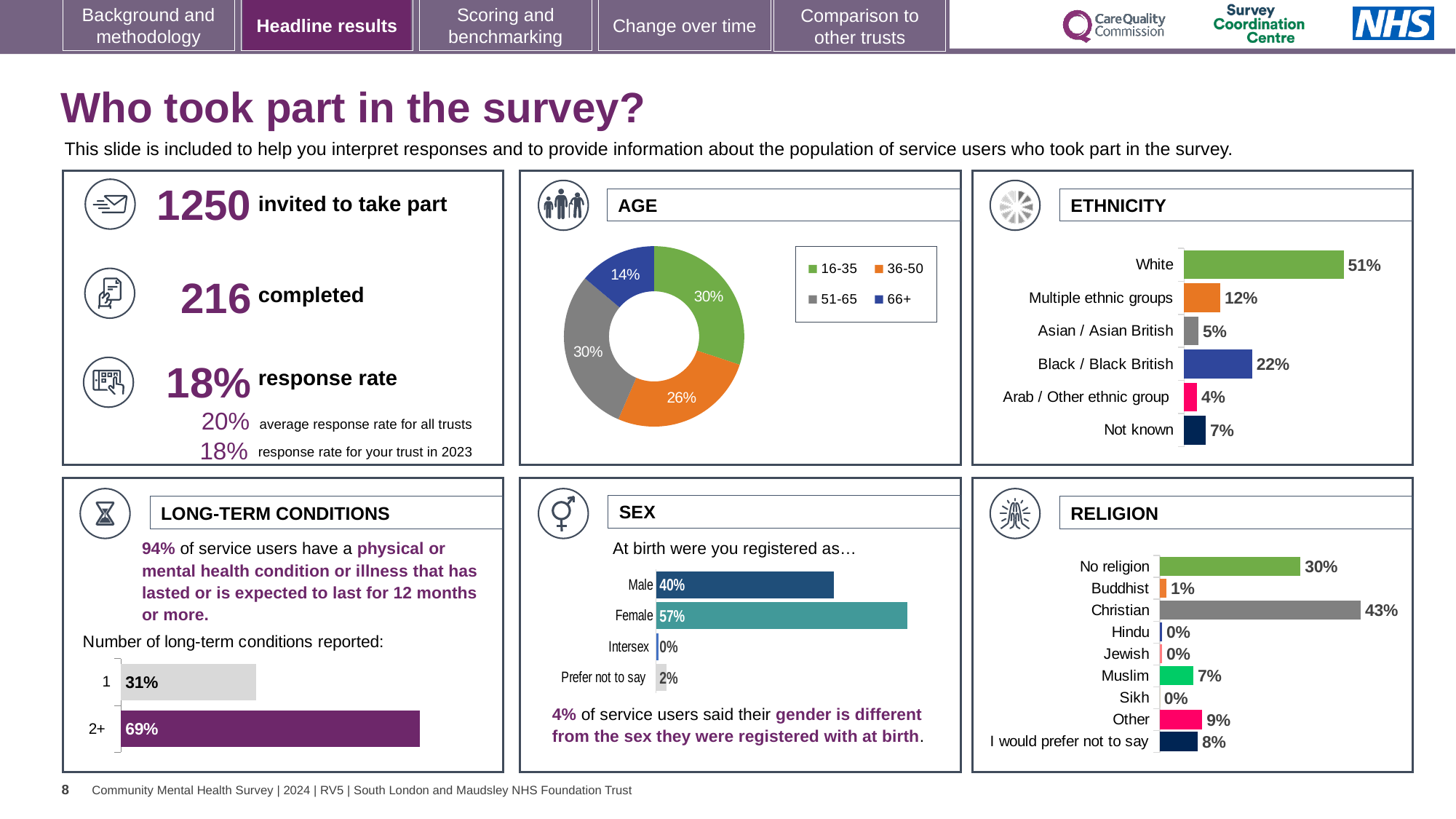
In the AGE chart, what percentage of respondents were aged 66+? 14% In the AGE chart, what percentage of respondents were aged 36-50? 26% In the LONG-TERM CONDITIONS chart, what percentage of service users reported 2+ long-term conditions? 69% In the RELIGION chart, which religion category has the highest percentage? Christian What kind of chart is the AGE chart? Donut (pie) chart In the ETHNICITY chart, which ethnic group has the highest percentage? White In the SEX chart, what percentage of respondents were registered as Female at birth? 57% In the ETHNICITY chart, what is the percentage for Black / Black British? 22% In the ETHNICITY chart, what is the difference between the percentages for White and Multiple ethnic groups? 39% In the ETHNICITY chart, which is larger: Asian / Asian British or Not known? Not known How many categories are shown in the RELIGION chart? 9 How many age groups does the legend of the AGE chart list? 4